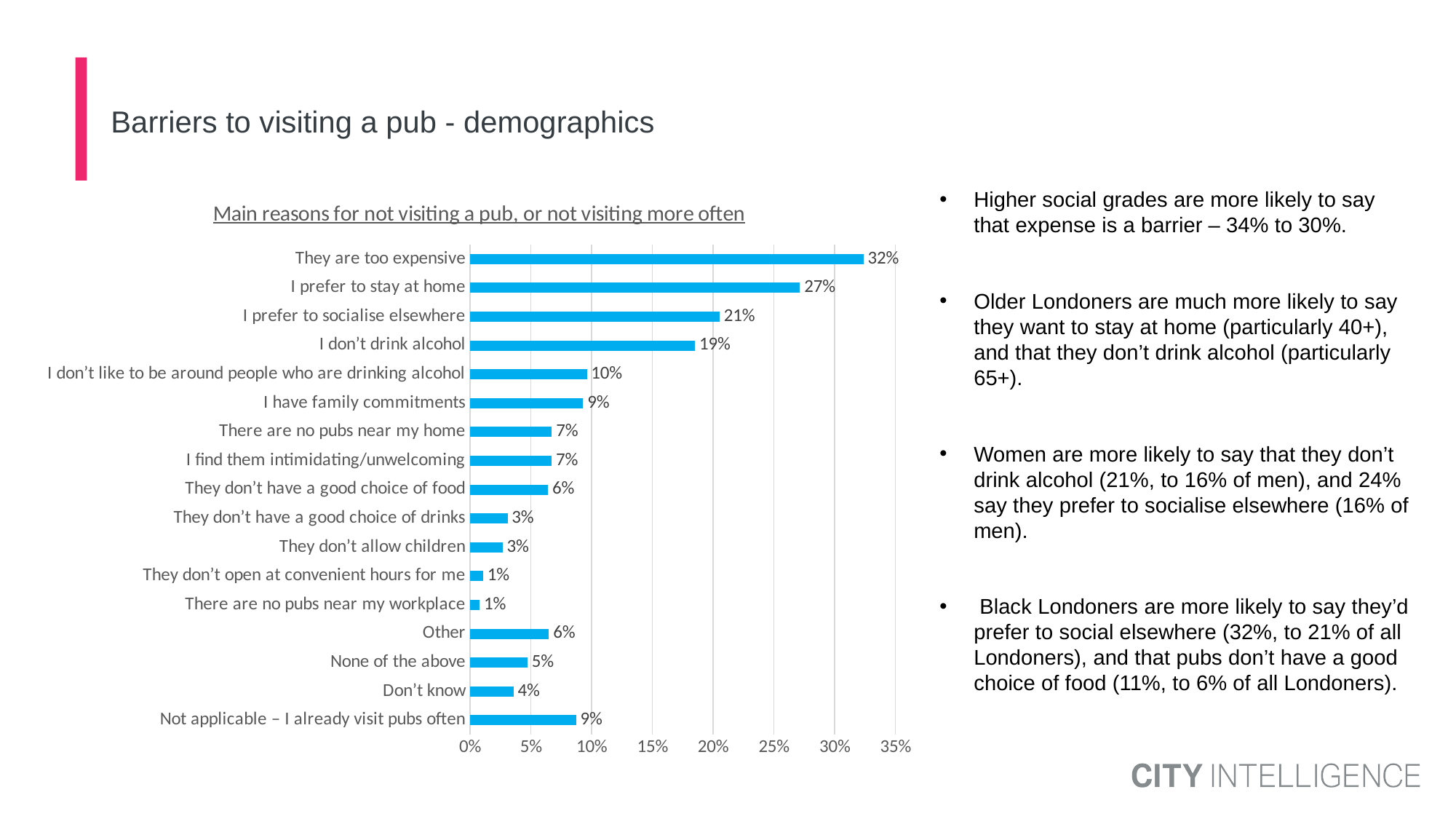
What percentage of respondents said pubs are too expensive? 32% What kind of chart is shown on the slide? Bar chart What percentage said "I don't drink alcohol"? 19% Is the value for "I prefer to socialise elsewhere" greater or less than 20%? greater What is the difference between "They are too expensive" and "I prefer to stay at home"? 5% Which reason has the highest percentage? They are too expensive What is the title of the chart? Main reasons for not visiting a pub, or not visiting more often What is the difference between "I prefer to socialise elsewhere" and "I don't drink alcohol"? 2% What is the value for "Not applicable – I already visit pubs often"? 9% How many categories are shown in the chart? 17 Which is larger: "I have family commitments" or "There are no pubs near my home"? I have family commitments What is the value for "I prefer to stay at home"? 27%